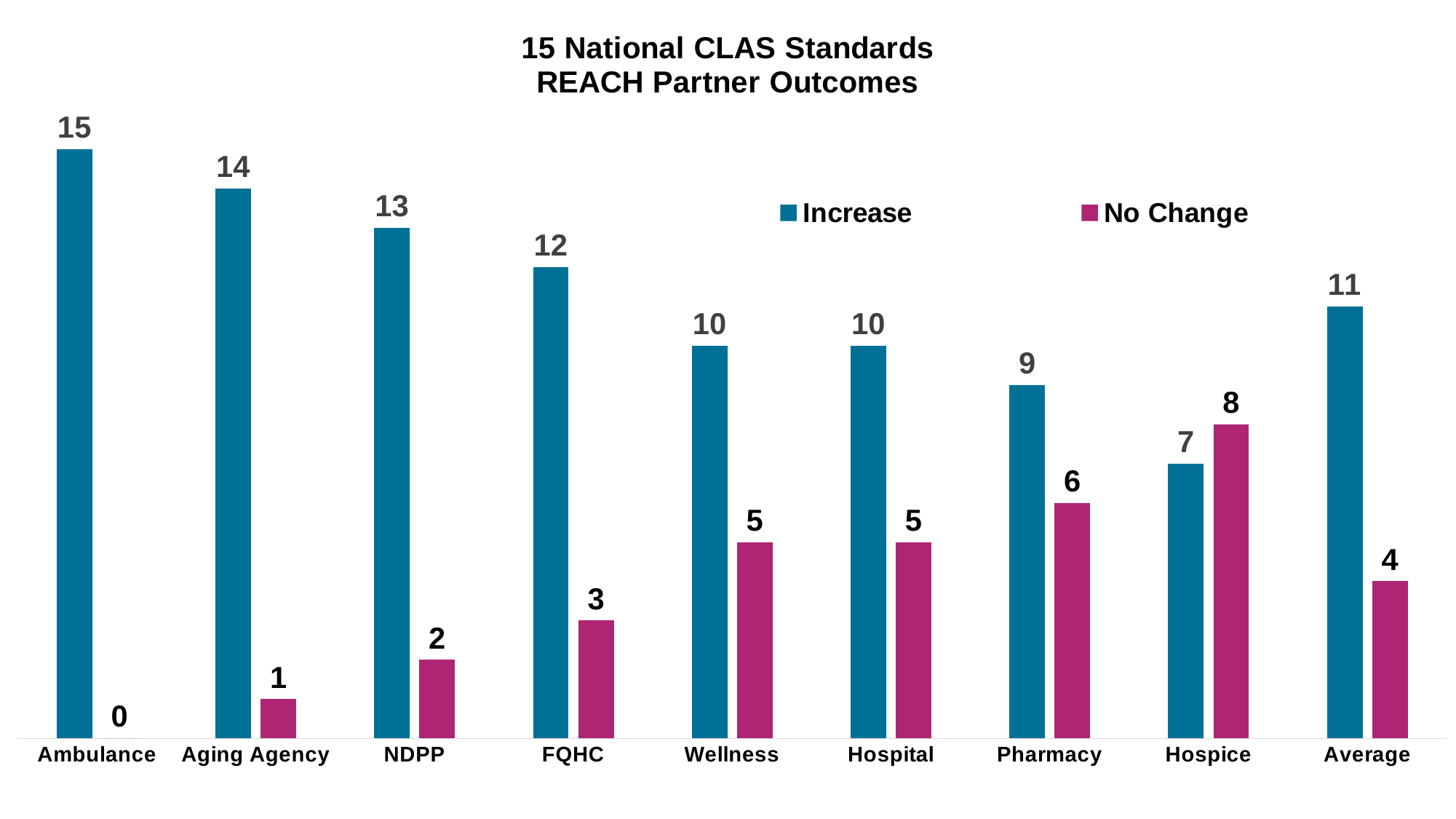
How many series does the legend list? 2 What kind of chart is shown? Bar chart Which category has the highest Increase value? Ambulance Which category has the lowest No Change value? Ambulance Which is larger for FQHC, the Increase value or the No Change value? Increase How many categories are shown on the x axis? 9 What is the Increase value for NDPP? 13 Which category has the highest No Change value? Hospice What is the No Change value for Pharmacy? 6 What is the title of the chart? 15 National CLAS Standards REACH Partner Outcomes What is the difference between the Increase and No Change values for Hospice? 1 What is the No Change value for Average? 4